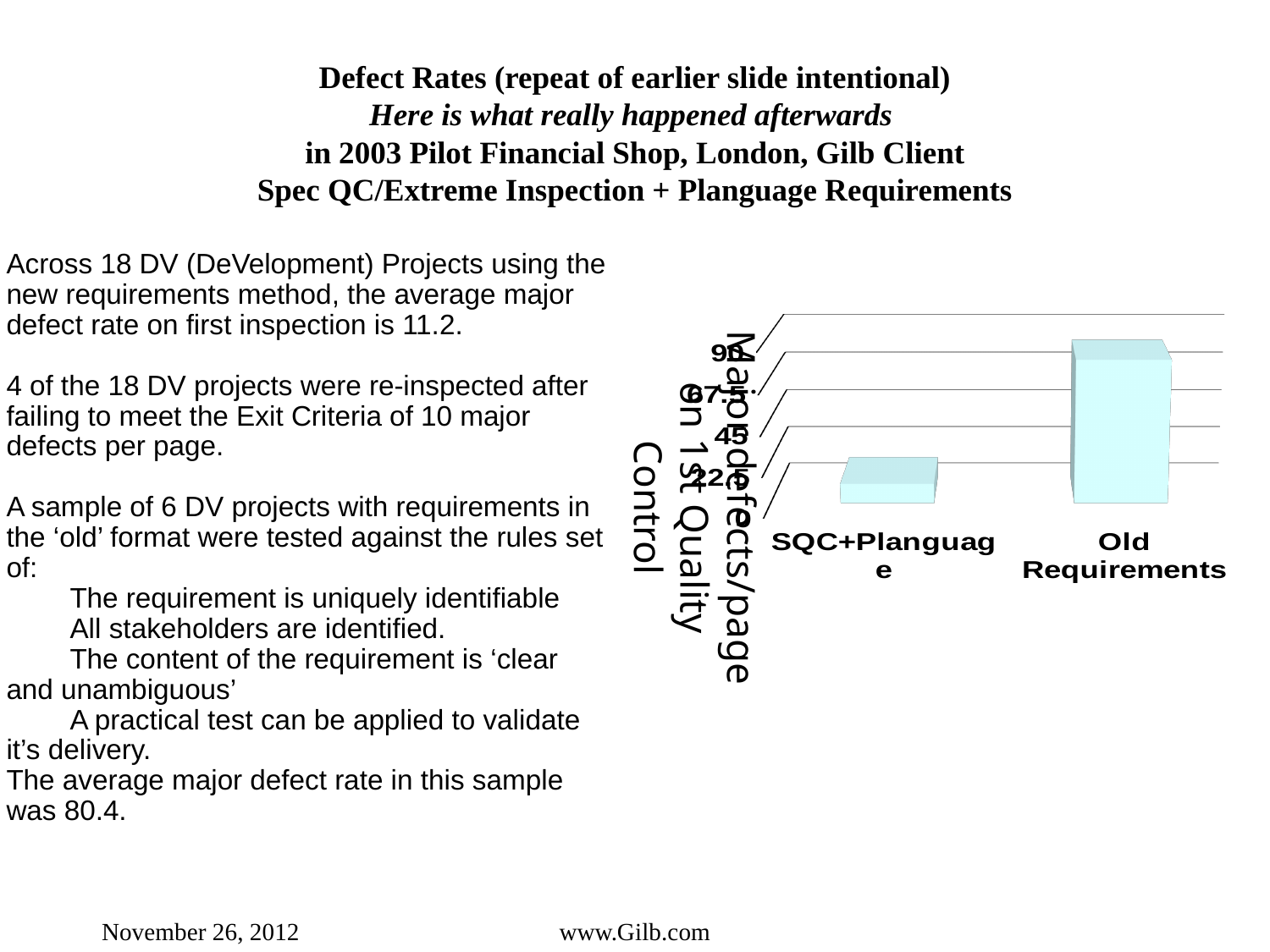
Which is larger, the bar for SQC+Planguage or the bar for Old Requirements? Old Requirements Is the value for SQC+Planguage greater or less than 45? less Is the value for Old Requirements greater or less than 22.5? greater Which category has the lowest bar in the chart? SQC+Planguage Is the value for Old Requirements greater or less than 45? greater What kind of chart is shown on the slide? bar chart How many categories are plotted in the chart? 2 What is the label of the second category on the x axis of the chart? Old Requirements Which category has the highest bar in the chart? Old Requirements What is the label of the first category on the x axis of the chart? SQC+Planguage